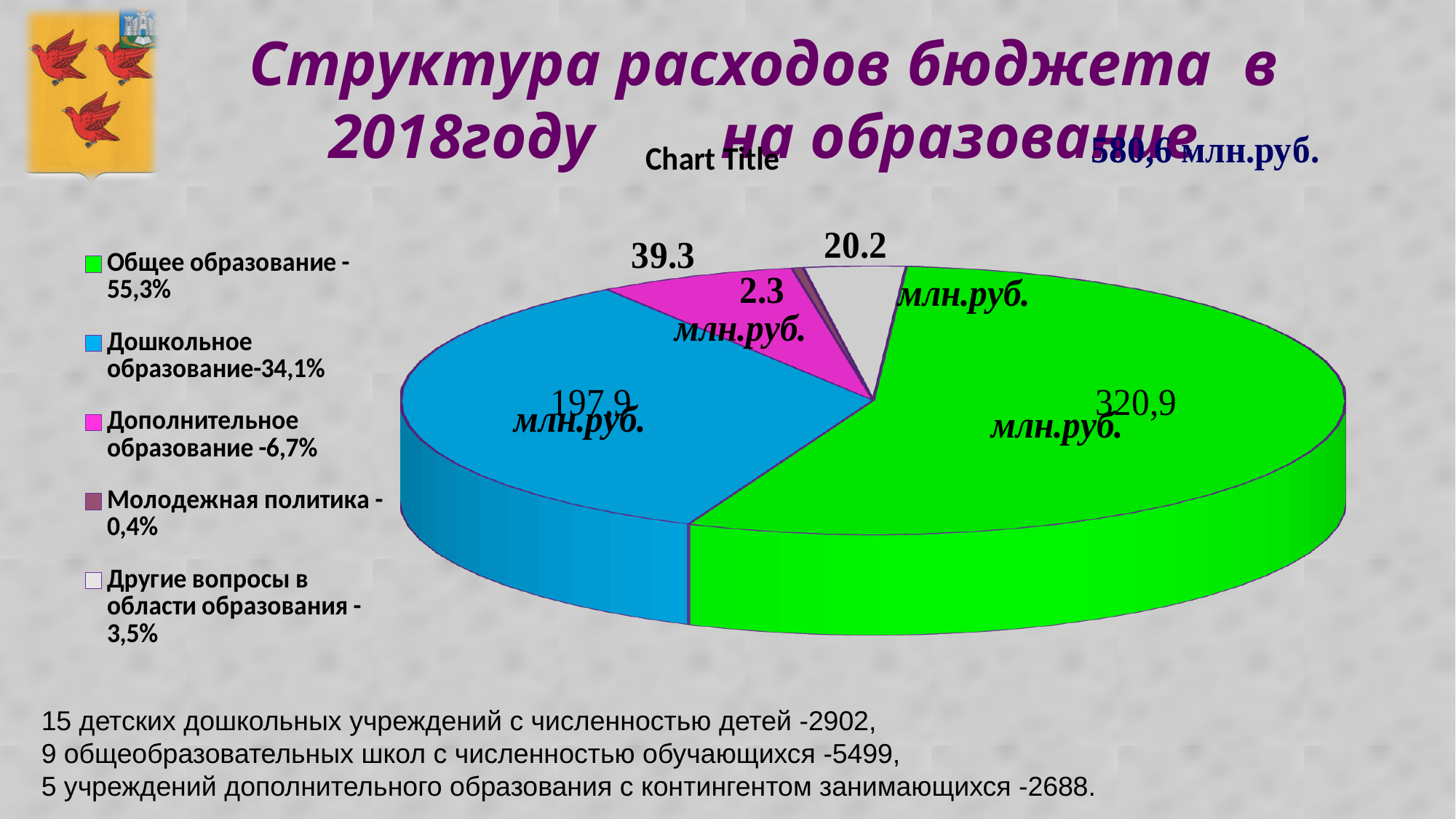
What kind of chart is shown on the slide? pie chart What share of the pie does Общее образование have? 55,3% What is the value shown for Общее образование? 320,9 млн.руб. Which category has the smallest slice of the pie? Молодежная политика How many categories does the pie chart have? 5 What share of the pie does Дошкольное образование have? 34,1% What is the difference between the values for Общее образование and Дошкольное образование? 123,0 млн.руб. What is the value shown for Дошкольное образование? 197,9 млн.руб. What colour is the slice for Общее образование? green What share of the pie does Другие вопросы в области образования have? 3,5% Which is larger: Дошкольное образование or Дополнительное образование? Дошкольное образование Which category has the largest slice of the pie? Общее образование